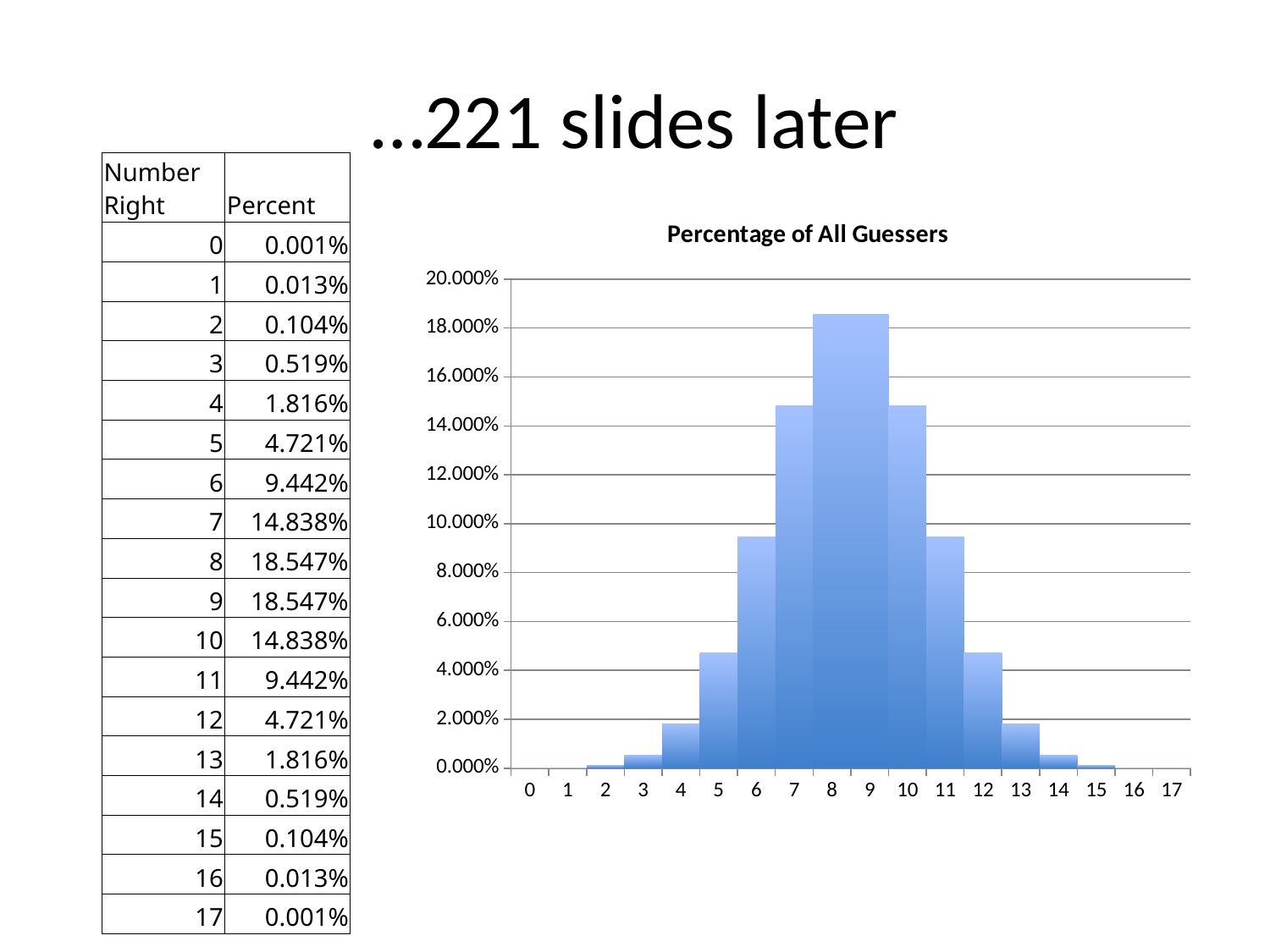
What is the highest percentage value plotted in the chart? 18.547% What is the percentage of all guessers for 8 right? 18.547% How many categories are shown along the x axis of the chart? 18 What is the percentage of all guessers for 13 right? 1.816% Which has a larger percentage of all guessers, 6 right or 5 right? 6 Is the value for 6 right greater or less than 10.000%? less What is the percentage of all guessers for 5 right? 4.721% What is the difference between the percentage for 8 right and the percentage for 7 right? 3.709% What is the title of the chart? Percentage of All Guessers What kind of chart is shown on the slide? bar chart Do the values rise or fall along the x axis from 0 to 8? rise What is the lowest percentage value plotted in the chart? 0.001%